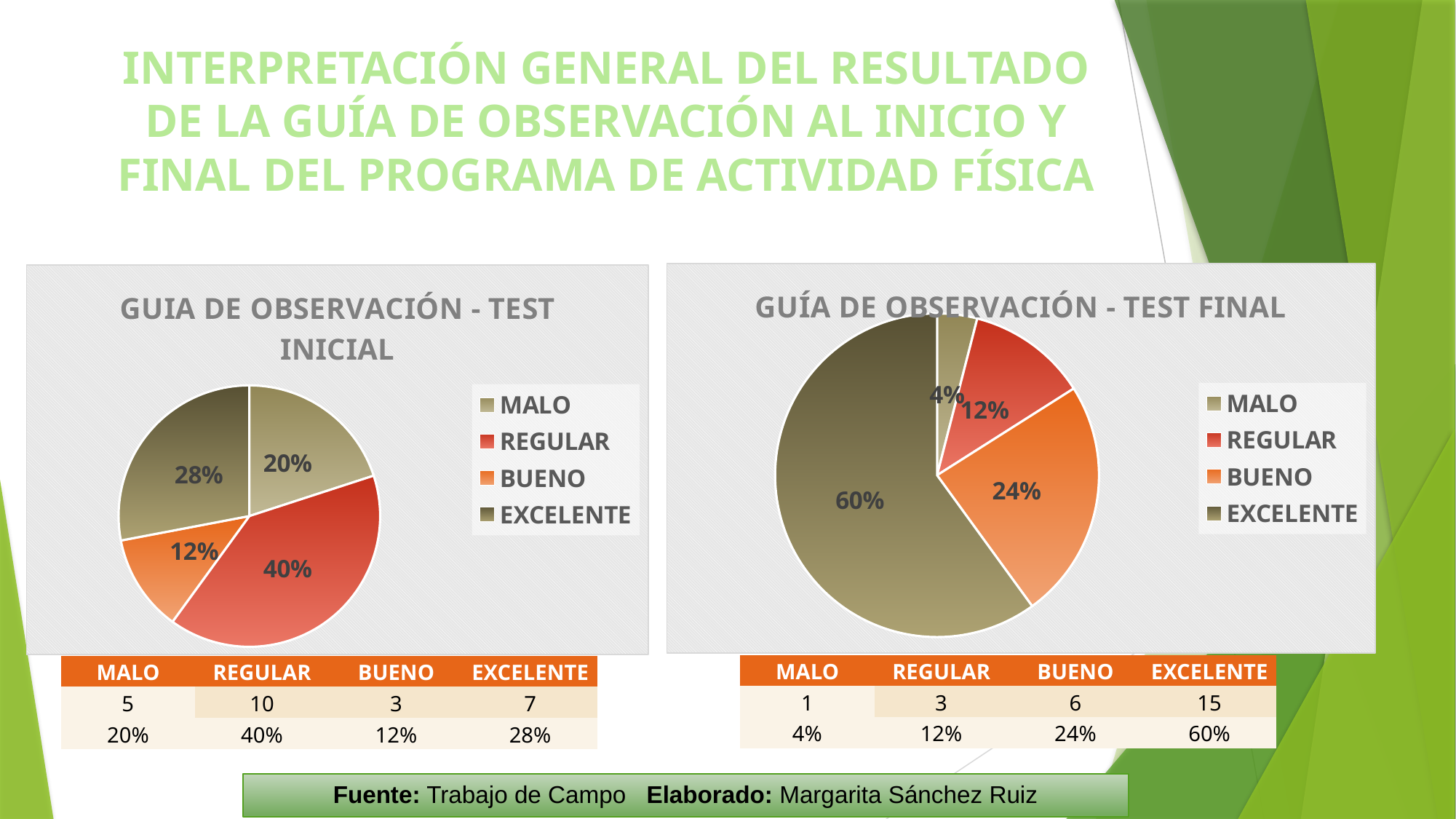
In the 'GUÍA DE OBSERVACIÓN - TEST FINAL' chart, what percentage is shown for EXCELENTE? 60% In the 'GUÍA DE OBSERVACIÓN - TEST FINAL' chart, what share of the pie does REGULAR represent? 12% In the 'GUIA DE OBSERVACIÓN - TEST INICIAL' chart, which is larger, the MALO slice or the EXCELENTE slice? EXCELENTE How many categories does the legend of the 'GUIA DE OBSERVACIÓN - TEST INICIAL' chart list? 4 In the 'GUÍA DE OBSERVACIÓN - TEST FINAL' chart, what is the difference in percentage points between EXCELENTE and BUENO? 36 What type of chart is 'GUÍA DE OBSERVACIÓN - TEST FINAL'? Pie chart In the 'GUÍA DE OBSERVACIÓN - TEST FINAL' chart, which category has the smallest slice? MALO In the 'GUIA DE OBSERVACIÓN - TEST INICIAL' chart, what percentage is shown for BUENO? 12% Which legend entry in the 'GUÍA DE OBSERVACIÓN - TEST FINAL' chart is shown in red? REGULAR In the 'GUIA DE OBSERVACIÓN - TEST INICIAL' chart, which category has the largest slice? REGULAR In the 'GUIA DE OBSERVACIÓN - TEST INICIAL' chart, which category has the smallest slice? BUENO In the 'GUIA DE OBSERVACIÓN - TEST INICIAL' chart, what percentage is shown for REGULAR? 40%